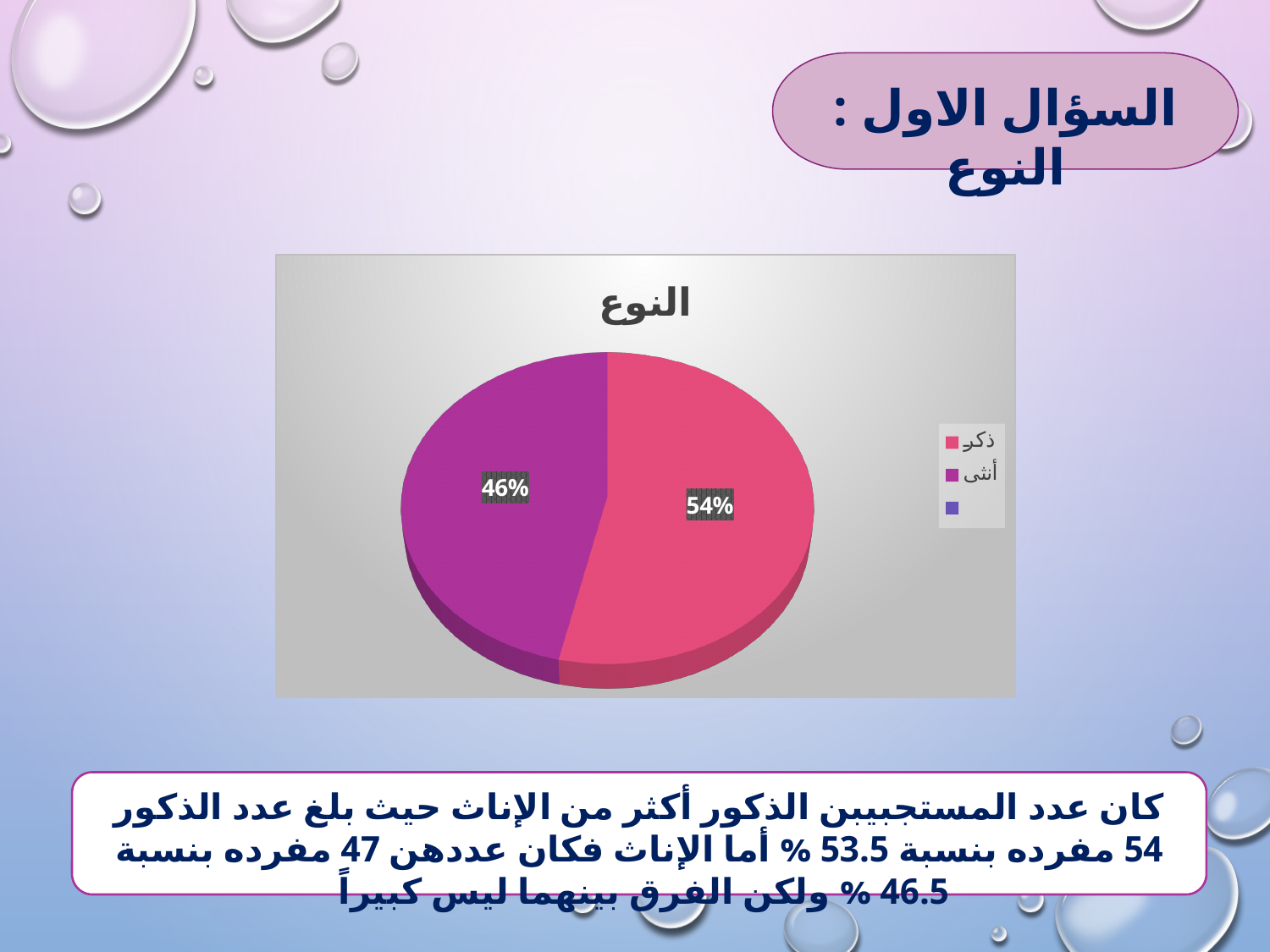
What is the difference in percentage points between the ذكر slice and the أنثى slice? 8% Which category has the largest slice of the pie? ذكر What colour is the ذكر slice in the pie chart? pink What is the combined share of the ذكر and أنثى slices? 100% How many labelled slices does the pie chart have? 2 What type of chart is shown on the slide? pie chart What percentage of the pie does the ذكر slice represent? 54% Is the share for أنثى greater or less than 50%? less What percentage of the pie does the أنثى slice represent? 46% Which category has the smallest slice of the pie? أنثى What is the title of the chart? النوع Which slice is larger, ذكر or أنثى? ذكر